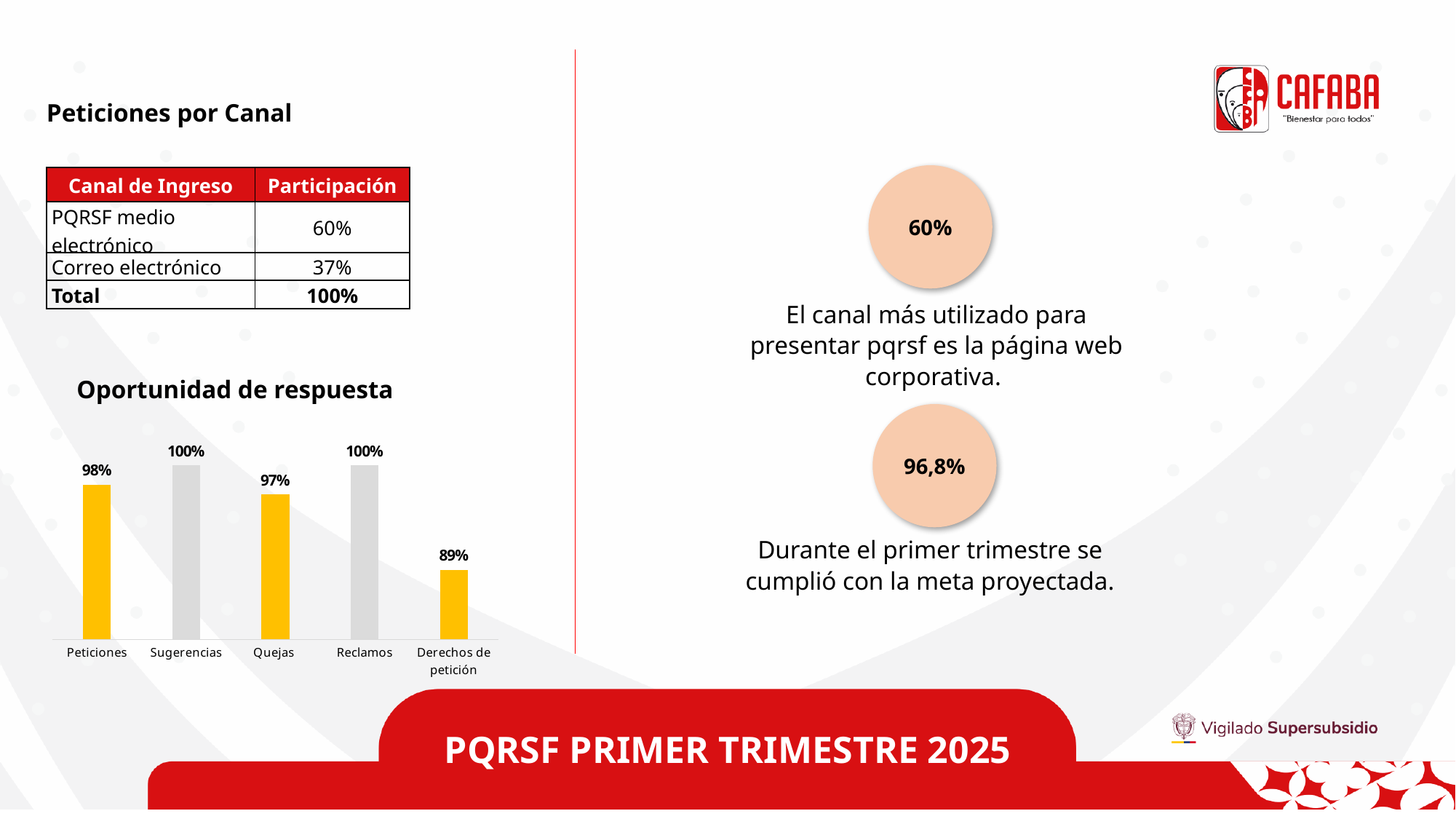
In the "Oportunidad de respuesta" chart, what is the value for Quejas? 97% In the "Oportunidad de respuesta" chart, how many categories have a value of 100%? 2 In the "Oportunidad de respuesta" chart, which is larger, the value for Peticiones or the value for Derechos de petición? Peticiones In the "Oportunidad de respuesta" chart, which category has the lowest value? Derechos de petición In the "Oportunidad de respuesta" chart, what is the value for Reclamos? 100% How many categories are shown in the "Oportunidad de respuesta" chart? 5 What is the title of the bar chart on the slide? Oportunidad de respuesta In the "Oportunidad de respuesta" chart, what is the value for Peticiones? 98% What kind of chart is "Oportunidad de respuesta"? Bar chart In the "Oportunidad de respuesta" chart, what is the difference between the values for Sugerencias and Derechos de petición? 11% In the "Oportunidad de respuesta" chart, what is the value for Derechos de petición? 89% In the "Oportunidad de respuesta" chart, what is the difference between the values for Peticiones and Quejas? 1%